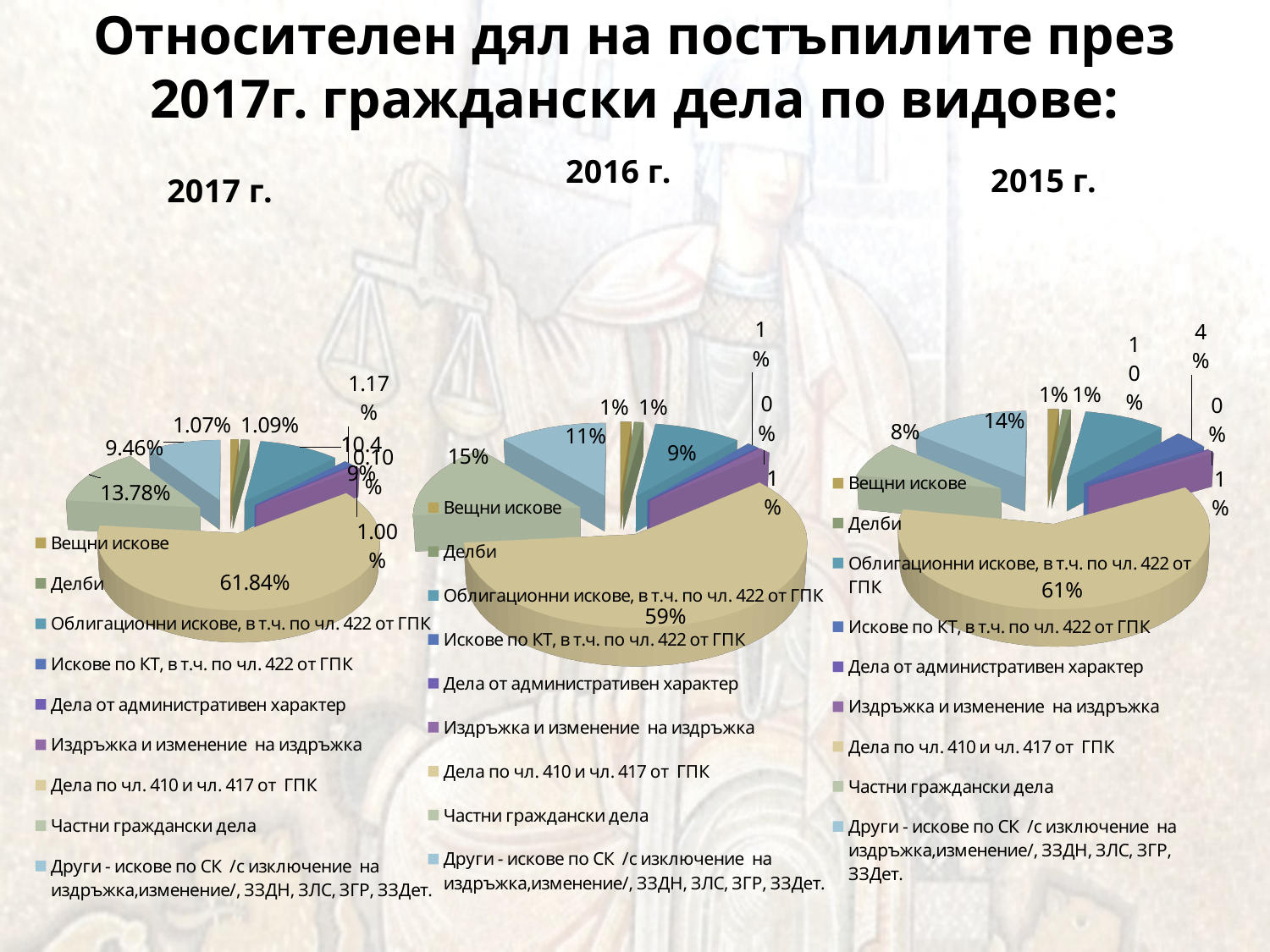
How many pie charts are on the slide? 3 In the 2017 г. chart, what is the share of Частни граждански дела? 13.78% In the 2017 г. chart, what is the value of the largest slice? 61.84% In the 2016 г. chart, what is the value of the largest slice? 59% What is the first entry in the legend of the 2015 г. chart? Вещни искове How many entries does the legend of the 2017 г. chart list? 9 In the 2015 г. chart, what is the share of Други - искове по СК /с изключение на издръжка,изменение/, ЗЗДН, ЗЛС, ЗГР, ЗЗДет.? 14% In the 2017 г. chart, what is the smallest labelled slice value? 0.10% In the 2015 г. chart, what is the value of the largest slice? 61% What kind of charts are shown on the slide? Pie charts In the 2017 г. chart, what is the share of Облигационни искове, в т.ч. по чл. 422 от ГПК? 10.49% Which chart has the larger largest slice, 2017 г. (61.84%) or 2016 г. (59%)? 2017 г.